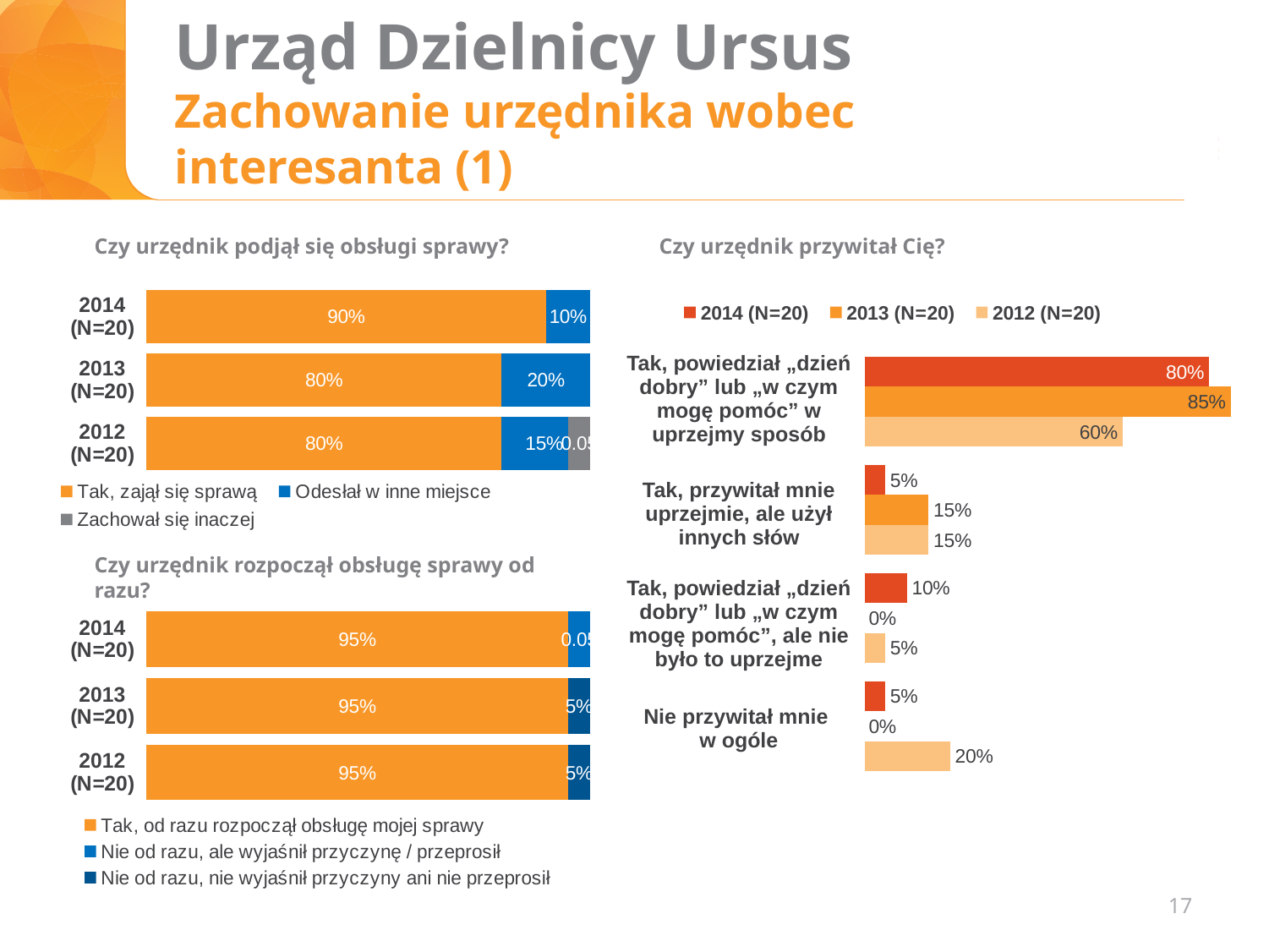
In the chart 'Czy urzędnik przywitał Cię?', which year has the lowest value for 'Tak, powiedział „dzień dobry” lub „w czym mogę pomóc” w uprzejmy sposób'? 2012 (N=20) In the chart 'Czy urzędnik podjął się obsługi sprawy?', what is the difference between the 'Tak, zajął się sprawą' values for 2014 and 2013? 10% In the chart 'Czy urzędnik rozpoczął obsługę sprawy od razu?', how many year categories are shown? 3 In the chart 'Czy urzędnik podjął się obsługi sprawy?', what percentage is shown for 'Tak, zajął się sprawą' in 2014 (N=20)? 90% In the chart 'Czy urzędnik przywitał Cię?', what is the 2012 (N=20) value for 'Nie przywitał mnie w ogóle'? 20% In the chart 'Czy urzędnik przywitał Cię?', which is larger for 'Tak, przywitał mnie uprzejmie, ale użył innych słów': the 2014 value or the 2013 value? 2013 (N=20) In the chart 'Czy urzędnik podjął się obsługi sprawy?', what is the value of 'Odesłał w inne miejsce' for 2013 (N=20)? 20% In the chart 'Czy urzędnik rozpoczął obsługę sprawy od razu?', what percentage is shown for 'Tak, od razu rozpoczął obsługę mojej sprawy' in 2012 (N=20)? 95% In the chart 'Czy urzędnik przywitał Cię?', what is the 2013 (N=20) value for 'Tak, powiedział „dzień dobry” lub „w czym mogę pomóc” w uprzejmy sposób'? 85% In the chart 'Czy urzędnik podjął się obsługi sprawy?', how many series does the legend list? 3 In the chart 'Czy urzędnik przywitał Cię?', how many response categories are shown? 4 What type of chart is 'Czy urzędnik rozpoczął obsługę sprawy od razu?' Stacked bar chart